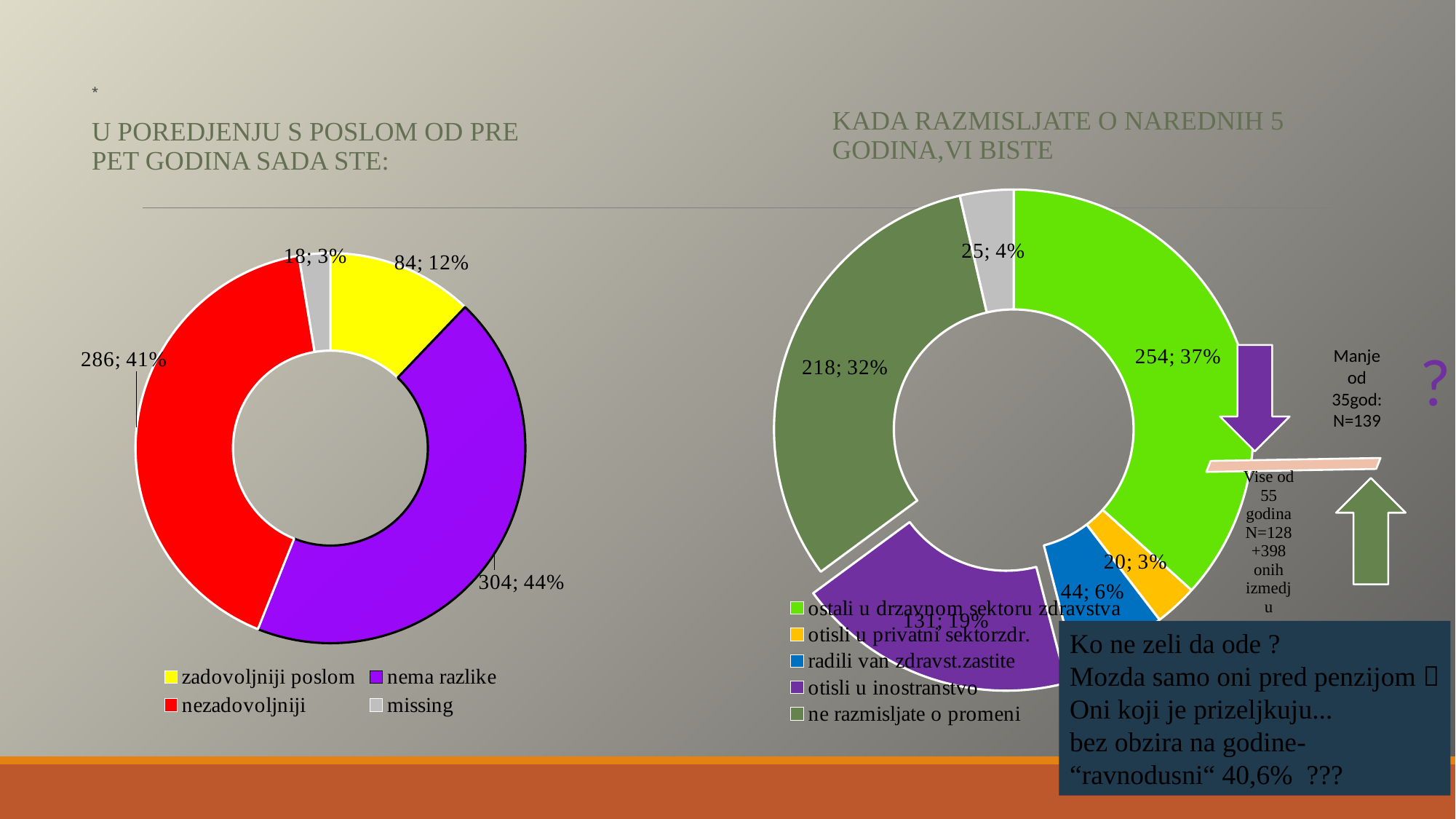
On the left chart, what is the difference in count between 'nema razlike' and 'nezadovoljniji'? 18 What kind of chart is the left chart? doughnut chart On the right chart, what is the difference in count between 'ostali u drzavnom sektoru zdravstva' and 'ne razmisljate o promeni'? 36 On the left chart, what percentage is shown for 'nezadovoljniji'? 41% On the right chart, which is larger: 'radili van zdravst.zastite' or 'otisli u privatni sektorzdr.'? radili van zdravst.zastite On the left chart, which category has the largest slice? nema razlike On the left chart, what value is shown for 'nema razlike'? 304; 44% How many entries does the legend of the right chart list? 5 On the left chart, which category has the smallest slice? missing On the right chart, what value is shown for 'ostali u drzavnom sektoru zdravstva'? 254; 37% How many categories does the legend of the left chart list? 4 On the right chart, what percentage is shown for 'otisli u inostranstvo'? 19%